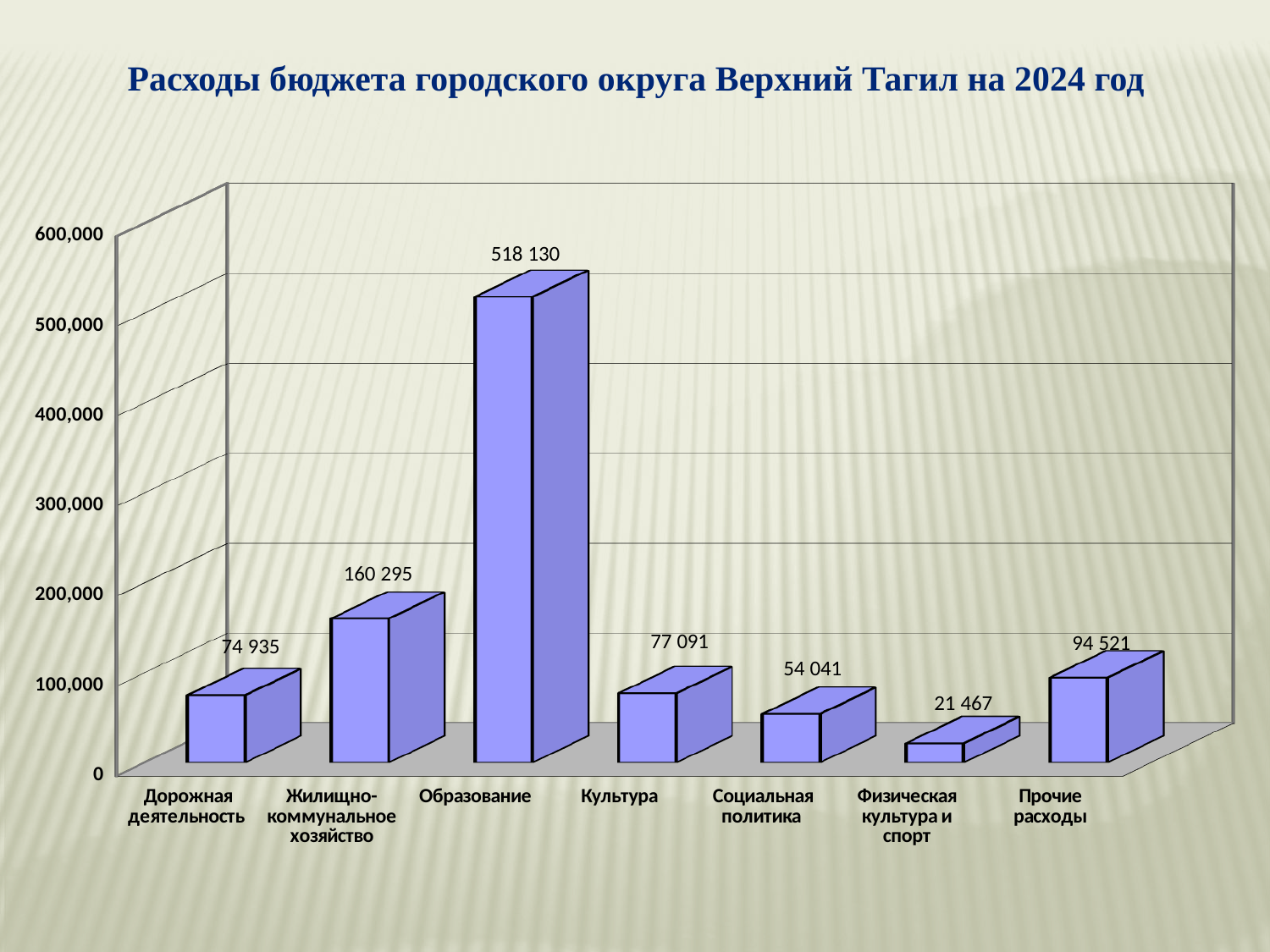
What kind of chart is shown on the slide? bar chart Is the value for Образование greater or less than 500,000? greater Which category has the lowest value? Физическая культура и спорт What is the value for Физическая культура и спорт? 21 467 What is the value for Прочие расходы? 94 521 Which is larger, the value for Социальная политика or the value for Прочие расходы? Прочие расходы What is the difference between the values for Прочие расходы and Дорожная деятельность? 19 586 Which category has the highest value? Образование What is the value for Жилищно-коммунальное хозяйство? 160 295 What is the value for Образование? 518 130 What is the difference between the values for Образование and Жилищно-коммунальное хозяйство? 357 835 How many categories are shown in the chart? 7